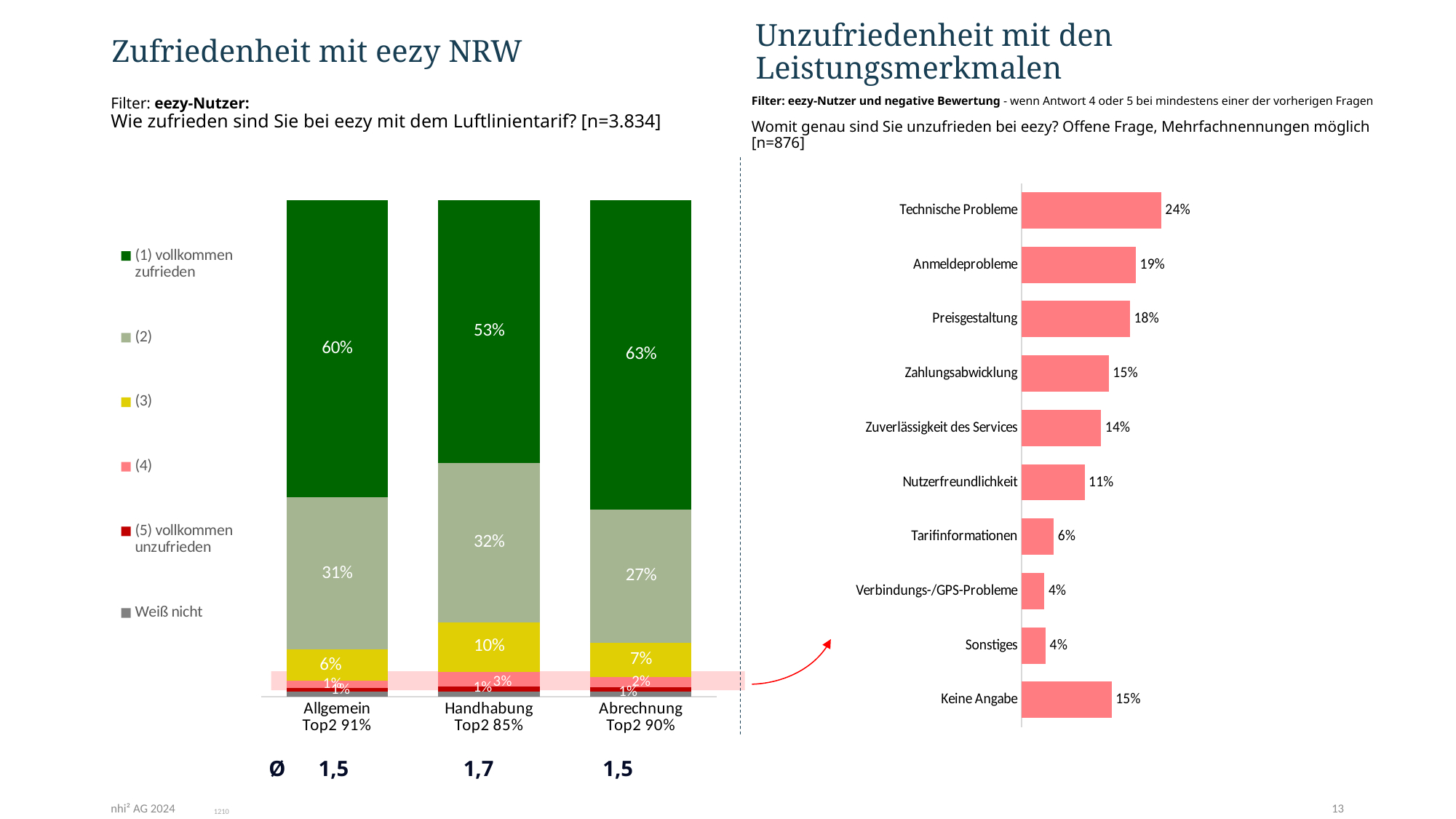
How many categories are shown in the 'Unzufriedenheit mit den Leistungsmerkmalen' chart? 10 In the 'Zufriedenheit mit eezy NRW' chart, what share of Abrechnung is '(2)'? 27% How many series does the legend of the 'Zufriedenheit mit eezy NRW' chart list? 6 In the 'Unzufriedenheit mit den Leistungsmerkmalen' chart, which category has the highest value? Technische Probleme In the 'Unzufriedenheit mit den Leistungsmerkmalen' chart, what is the value for Technische Probleme? 24% In the 'Unzufriedenheit mit den Leistungsmerkmalen' chart, which is larger: Preisgestaltung or Zahlungsabwicklung? Preisgestaltung What kind of chart is the 'Unzufriedenheit mit den Leistungsmerkmalen' chart? Horizontal bar chart In the 'Zufriedenheit mit eezy NRW' chart, what share of Handhabung is '(1) vollkommen zufrieden'? 53% In the 'Zufriedenheit mit eezy NRW' chart, what is the Top2 value shown for Handhabung? 85% In the 'Zufriedenheit mit eezy NRW' chart, which category has the highest '(1) vollkommen zufrieden' share? Abrechnung In the 'Unzufriedenheit mit den Leistungsmerkmalen' chart, what is the value for Zuverlässigkeit des Services? 14% In the 'Unzufriedenheit mit den Leistungsmerkmalen' chart, what is the difference between Anmeldeprobleme and Nutzerfreundlichkeit? 8%